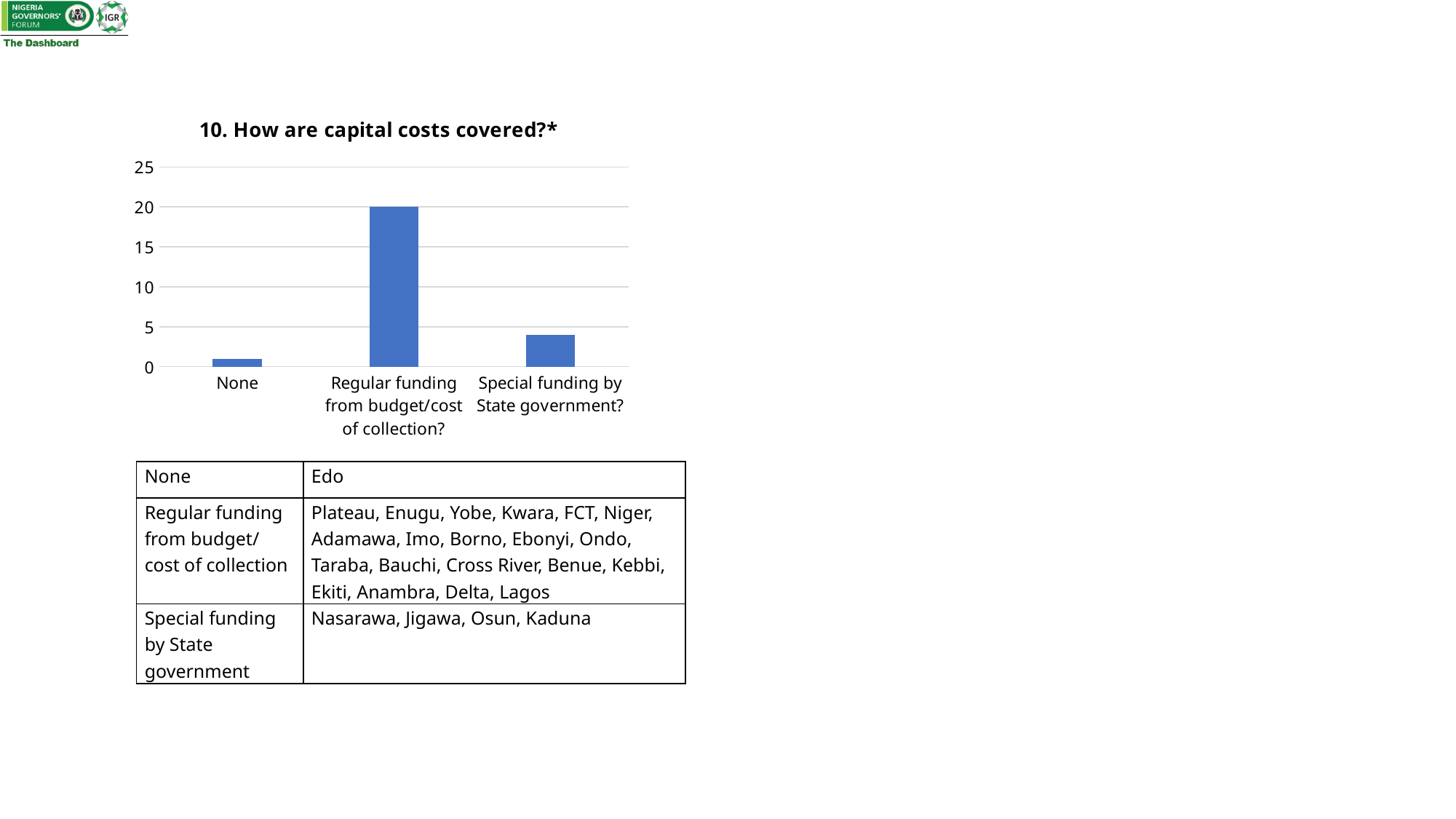
Which is larger: the value for "Special funding by State government?" or the value for "None"? Special funding by State government? Which category has the lowest value in the chart? None Is the value for "Regular funding from budget/cost of collection?" greater or less than 15? greater How many categories are shown on the x axis of the chart? 3 What kind of chart is shown on the slide? bar chart What is the value for "Regular funding from budget/cost of collection?"? 20 Is the value for "Special funding by State government?" greater or less than 5? less Which category has the highest value in the chart? Regular funding from budget/cost of collection? Is the value for "None" greater or less than 5? less What is the title of the chart? 10. How are capital costs covered?* What is the highest value shown on the y axis of the chart? 25